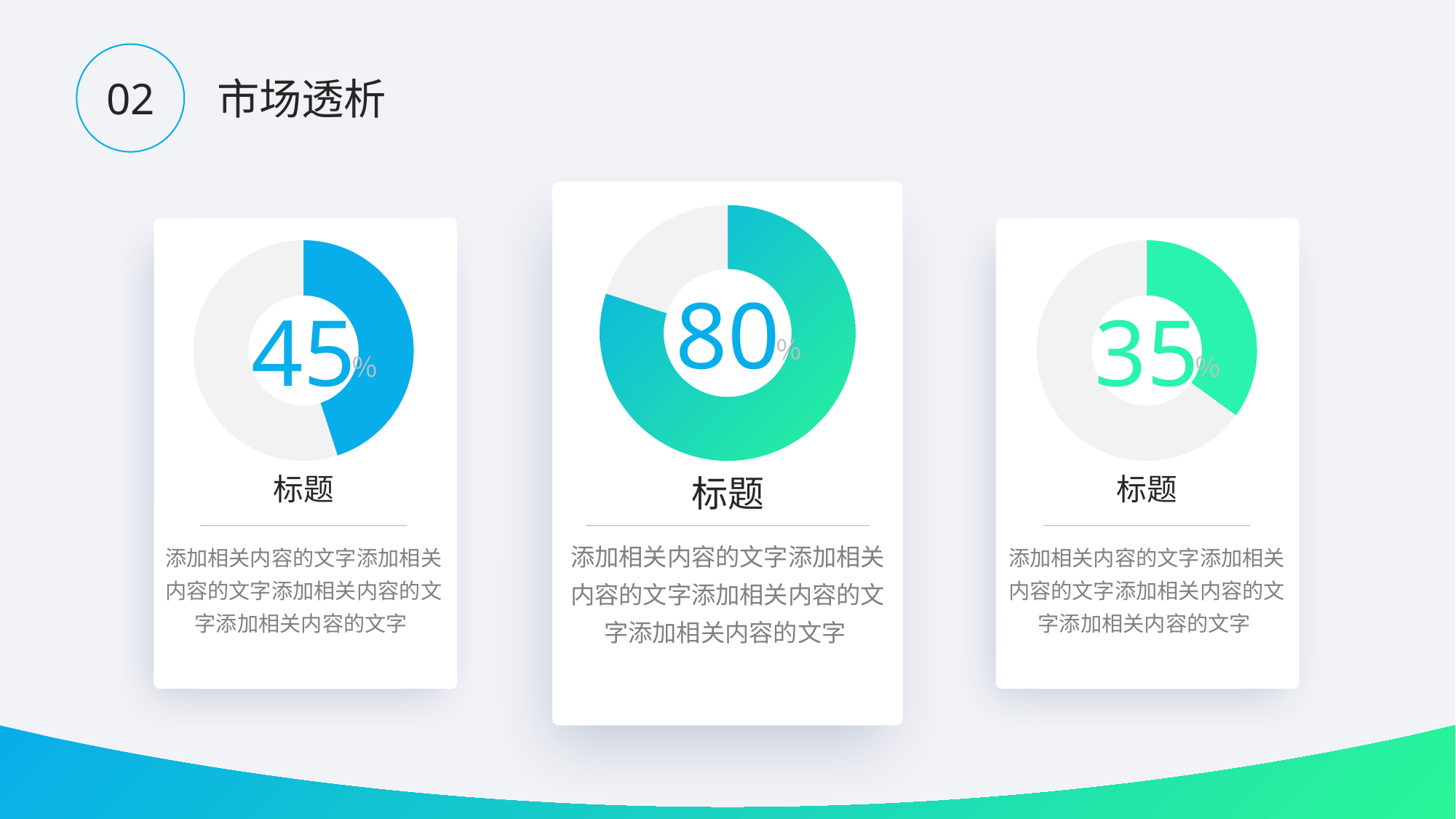
Which is larger, the percentage in the left donut chart or the percentage in the right donut chart? The left chart (45%) What percentage is shown in the centre of the left donut chart? 45% What percentage is shown in the centre of the right donut chart? 35% Which of the three donut charts shows the highest percentage? The middle chart (80%) What kind of chart is used in each of the three cards on the slide? Donut (pie) chart What is the difference between the percentage in the left donut chart and the percentage in the right donut chart? 10% How many donut charts are shown on the slide? 3 Which of the three donut charts shows the lowest percentage? The right chart (35%) Is the percentage shown in the middle donut chart greater or less than 50%? greater What is the difference between the percentage in the middle donut chart and the percentage in the left donut chart? 35% What percentage is shown in the centre of the middle donut chart? 80% What colour is the filled portion of the left donut chart? Blue